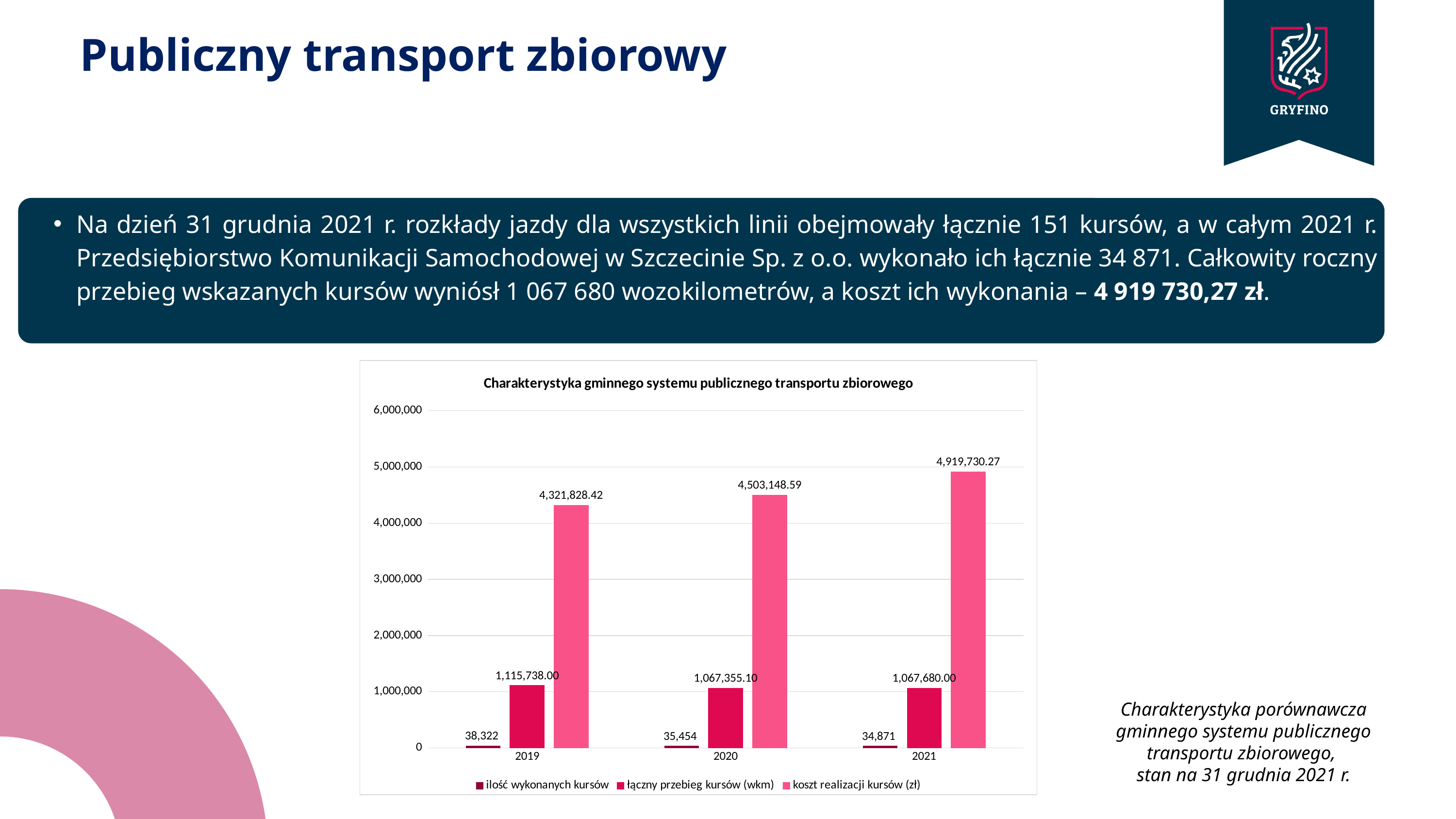
In which year is koszt realizacji kursów (zł) the highest? 2021 What is the difference between ilość wykonanych kursów in 2019 and in 2021? 3,451 In which year is ilość wykonanych kursów the lowest? 2021 How many series does the chart legend list? 3 Which is larger: łączny przebieg kursów (wkm) in 2019 or in 2021? 2019 What is the value of koszt realizacji kursów (zł) for 2021? 4,919,730.27 How many years are shown on the x axis of the chart? 3 What is the difference between koszt realizacji kursów (zł) in 2021 and in 2019? 597,901.85 Is the value of koszt realizacji kursów (zł) for 2020 greater or less than 4,000,000? greater What is the value of ilość wykonanych kursów for 2019? 38,322 What is the value of łączny przebieg kursów (wkm) for 2020? 1,067,355.10 Does koszt realizacji kursów (zł) rise or fall from 2019 to 2021? rise